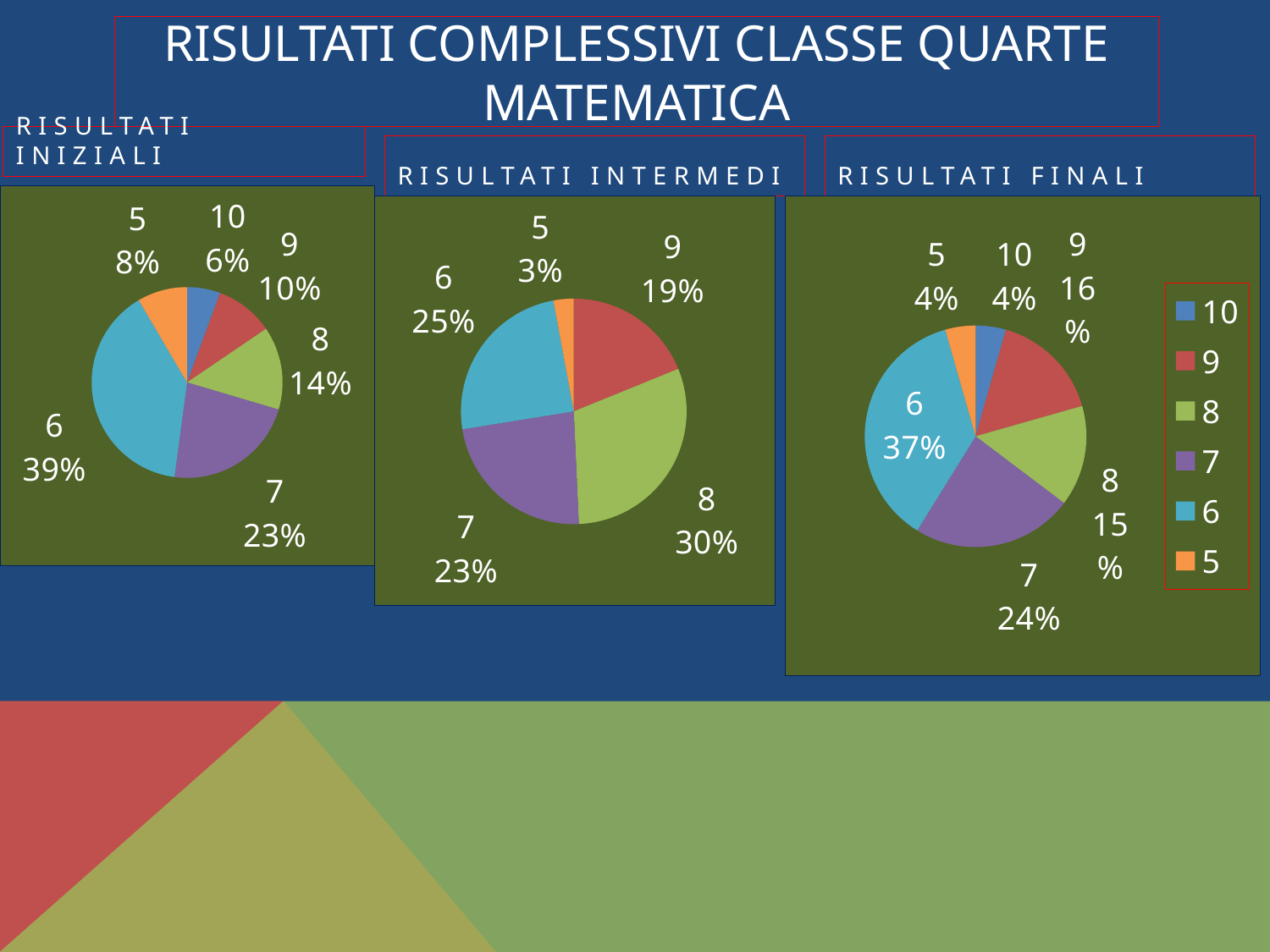
In the RISULTATI FINALI pie chart, which grade has the largest share? 6 In the RISULTATI INTERMEDI pie chart, which is larger, the share for grade 6 or the share for grade 7? 6 How many slices are labelled in the RISULTATI INTERMEDI pie chart? 5 How many entries does the legend next to the RISULTATI FINALI chart list? 6 In the RISULTATI INTERMEDI pie chart, which grade has the largest share? 8 In the RISULTATI INIZIALI pie chart, what is the difference between the shares for grade 7 and grade 8? 9% In the RISULTATI INIZIALI pie chart, which grade has the smallest share? 10 In the RISULTATI INTERMEDI pie chart, what share is shown for grade 8? 30% In the RISULTATI FINALI pie chart, what is the difference between the shares for grade 9 and grade 8? 1% In the RISULTATI FINALI pie chart, what share is shown for grade 7? 24% What type of chart is used for the RISULTATI FINALI results? Pie chart In the RISULTATI INIZIALI pie chart, what share is shown for grade 6? 39%